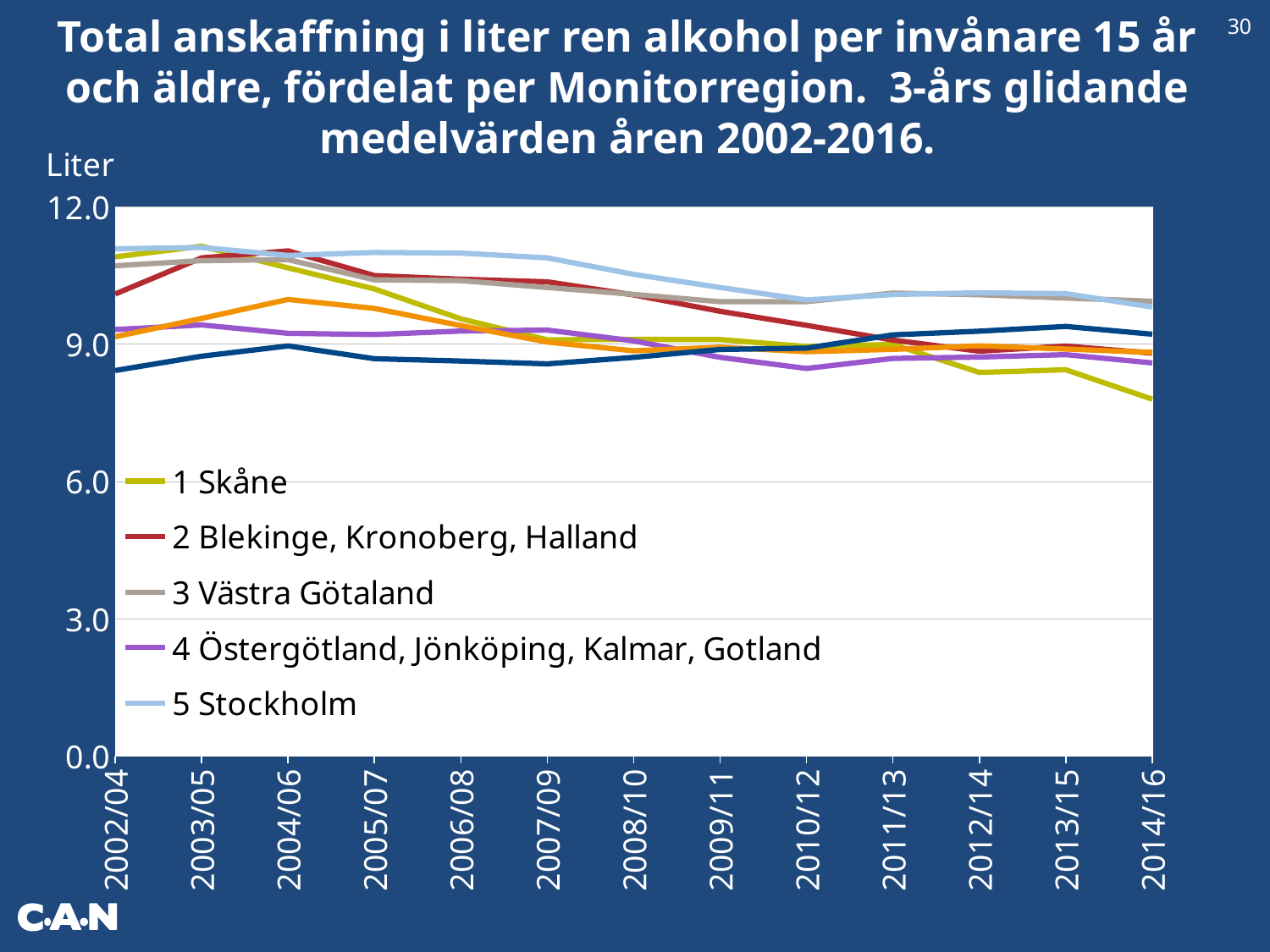
Is the value for 4 Östergötland, Jönköping, Kalmar, Gotland in 2010/12 greater or less than 9.0? less Which is larger in 2014/16, the value for 1 Skåne or the value for 5 Stockholm? 5 Stockholm Is the value for 5 Stockholm in 2014/16 greater or less than 9.0? greater How many series does the legend list? 5 Is the value for 1 Skåne in 2002/04 greater or less than 9.0? greater Which is larger in 2002/04, the value for 1 Skåne or the value for 4 Östergötland, Jönköping, Kalmar, Gotland? 1 Skåne What label is shown on the vertical axis? Liter Does the value for 1 Skåne rise or fall from 2002/04 to 2014/16? fall What kind of chart is shown on the slide? line chart How many periods are shown along the x axis? 13